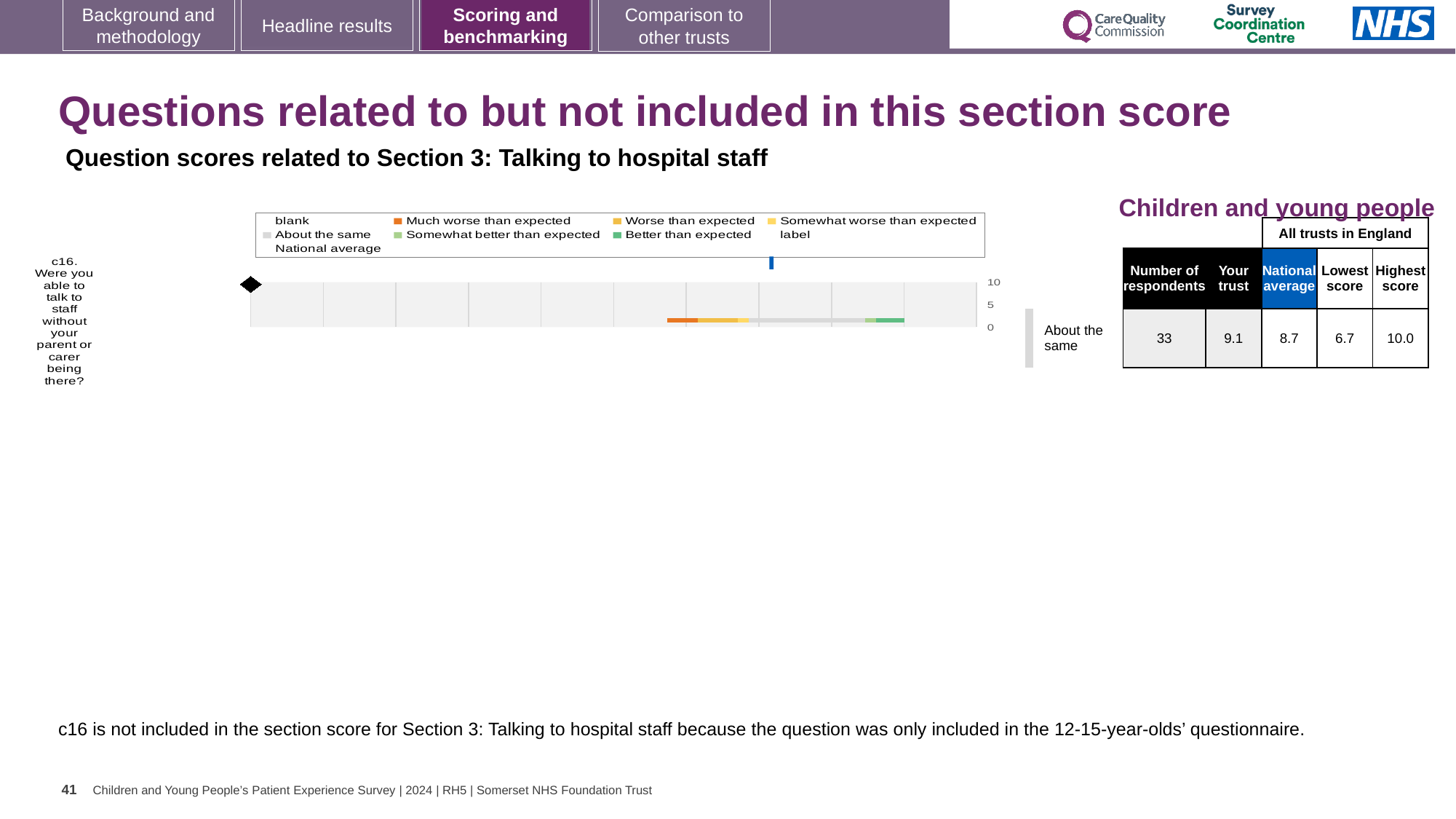
According to the table next to the chart, what is the national average score for c16? 8.7 According to the table next to the chart, what is the 'Your trust' score for c16? 9.1 What kind of chart is shown on the slide for question c16? bar chart How many respondents answered question c16? 33 What benchmark category label is shown beside the chart for the trust's c16 result? About the same Which is larger for c16, the 'Your trust' score or the national average? Your trust What is the difference between the highest and lowest scores among all trusts in England for c16? 3.3 According to the table next to the chart, what is the highest score among all trusts in England for c16? 10.0 In the chart legend, what colour represents 'Much worse than expected'? orange Which survey question is plotted in the chart? c16. Were you able to talk to staff without your parent or carer being there? What is the difference between the 'Your trust' score and the national average for c16? 0.4 According to the table next to the chart, what is the lowest score among all trusts in England for c16? 6.7